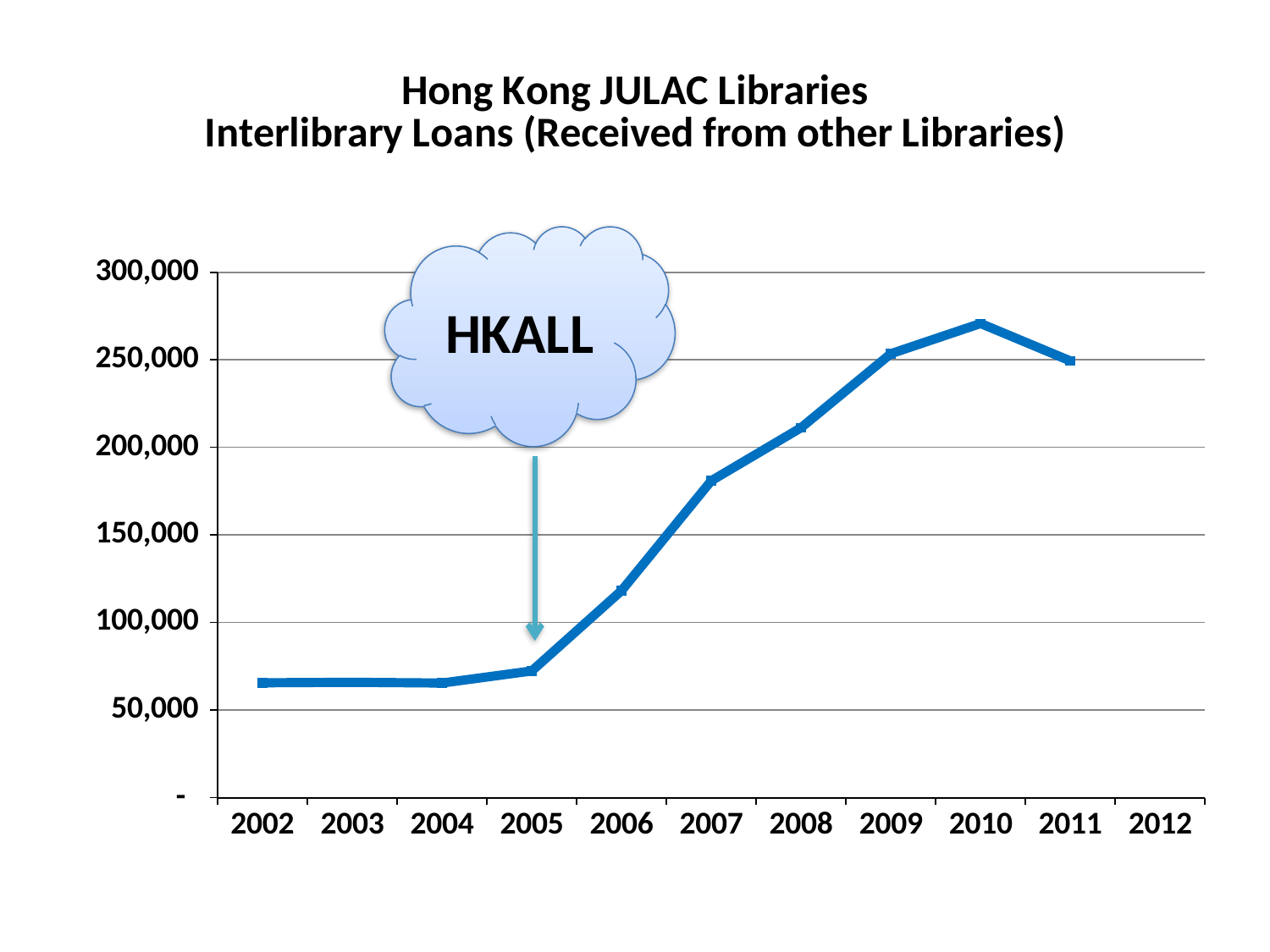
Is the value for 2010 greater or less than 250,000? greater Which year has the highest number of interlibrary loans received? 2010 Is the value for 2002 greater or less than 100,000? less Is the value for 2007 greater or less than 200,000? less Do the values rise or fall between 2005 and 2010? rise Which year has the larger value, 2010 or 2011? 2010 How many years have a plotted data point on the line? 10 What kind of chart is shown on the slide? line chart What label is written inside the cloud shape pointing to 2005? HKALL Which year has the larger value, 2006 or 2007? 2007